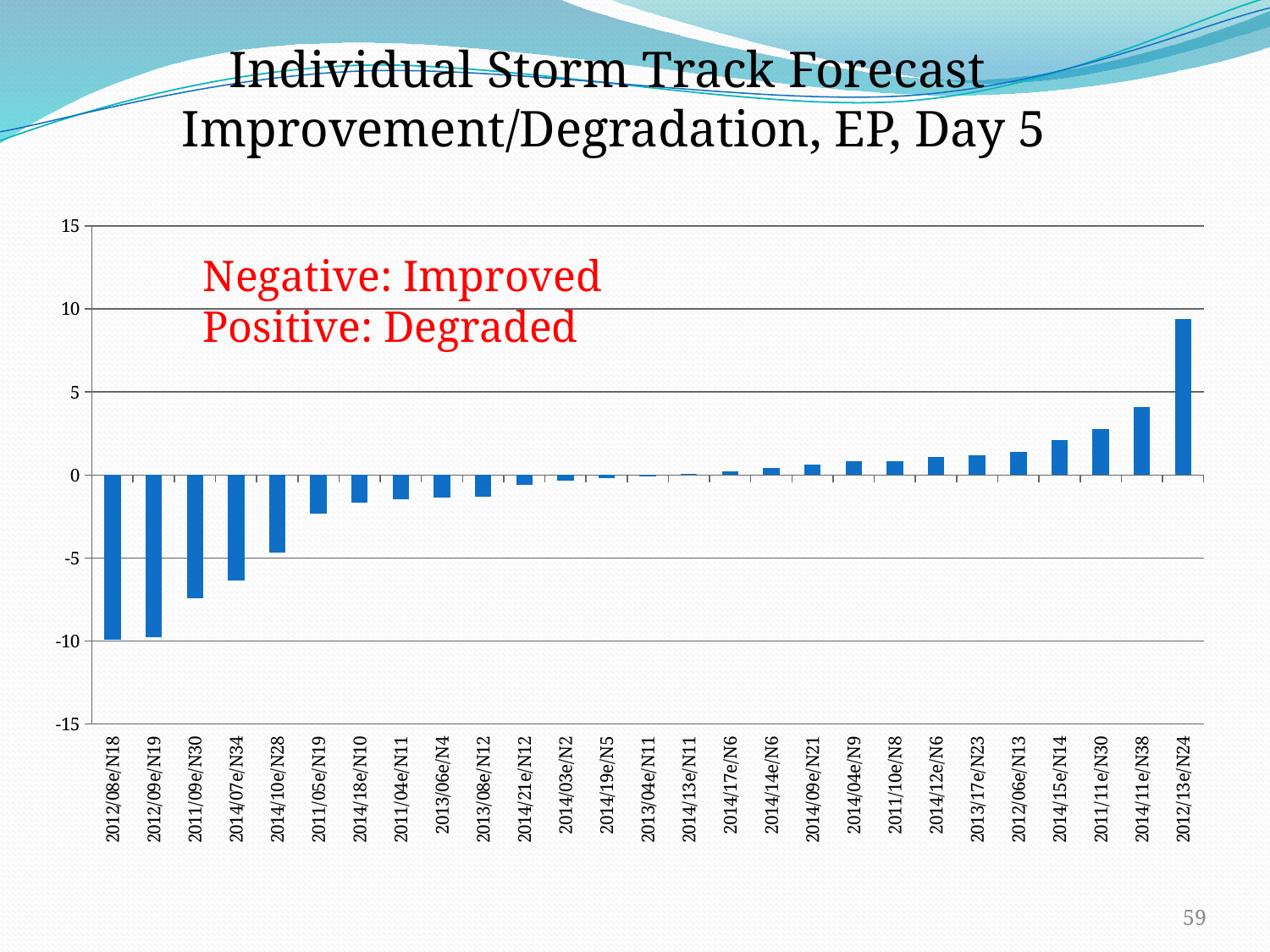
Is the value for 2014/07e/N34 greater or less than -5? less Is the value for 2012/08e/N18 greater or less than -5? less Which has the larger value, 2012/13e/N24 or 2014/11e/N38? 2012/13e/N24 What kind of chart is shown on the slide? bar chart How many storm categories are plotted along the x axis? 27 Is the value for 2012/13e/N24 greater or less than 5? greater Which has the larger value, 2011/09e/N30 or 2014/07e/N34? 2014/07e/N34 Which storm has the highest (most positive) value? 2012/13e/N24 According to the red annotation on the chart, what does a negative value indicate? Improved Do the bar values generally rise or fall from left to right along the x axis? rise